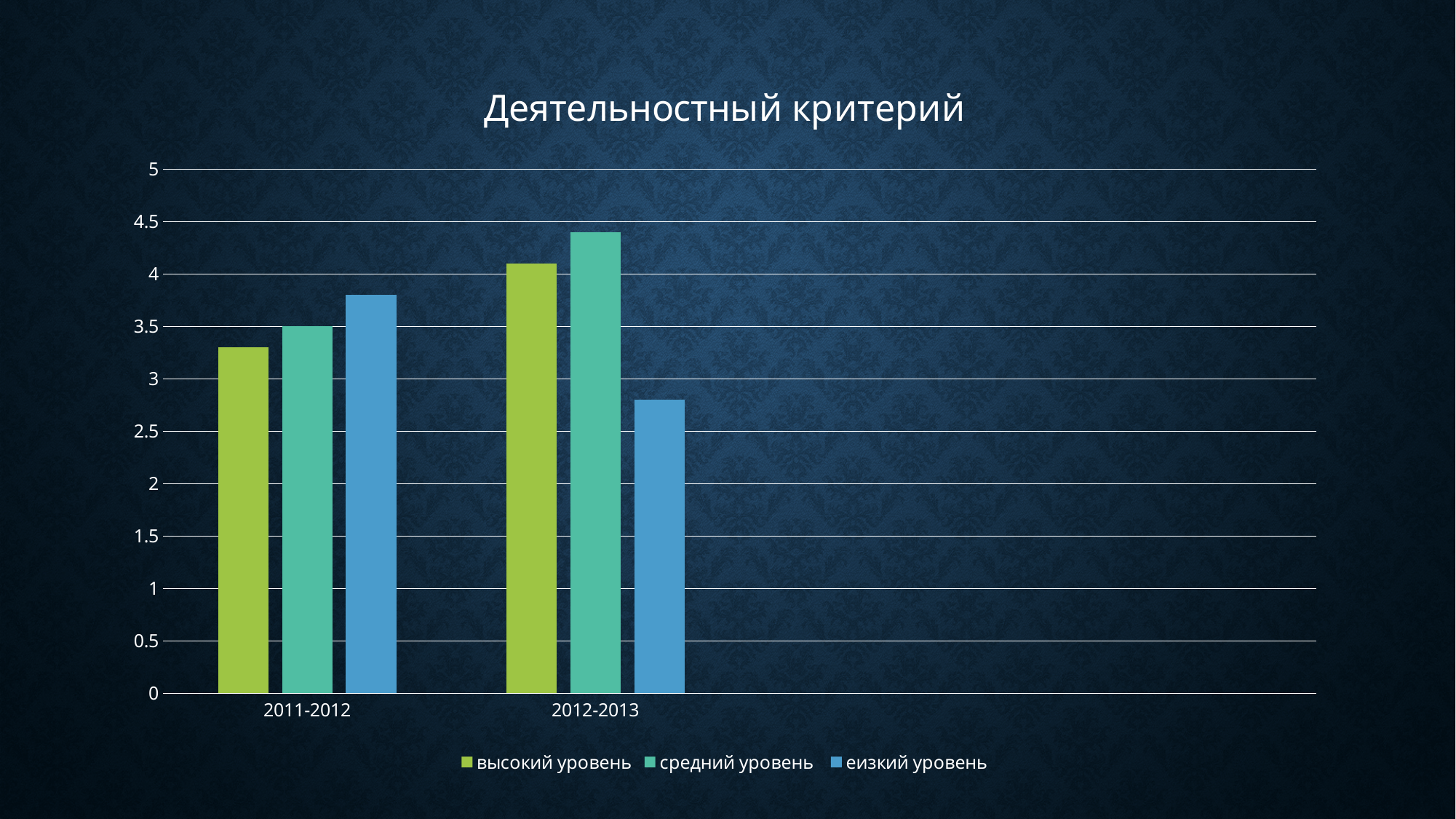
How many categories are shown on the x axis? 2 Is the value for высокий уровень in 2011-2012 greater or less than 3.5? less Is the value for еизкий уровень in 2011-2012 greater or less than 3.5? greater Which series has the lowest bar in 2012-2013? еизкий уровень Which series has the highest bar in 2012-2013? средний уровень What is the title of the chart? Деятельностный критерий Does the value for еизкий уровень rise or fall from 2011-2012 to 2012-2013? fall What kind of chart is shown on the slide? bar chart How many series does the legend list? 3 Is the value for еизкий уровень in 2012-2013 greater or less than 3? less What is the value for средний уровень in 2011-2012? 3.5